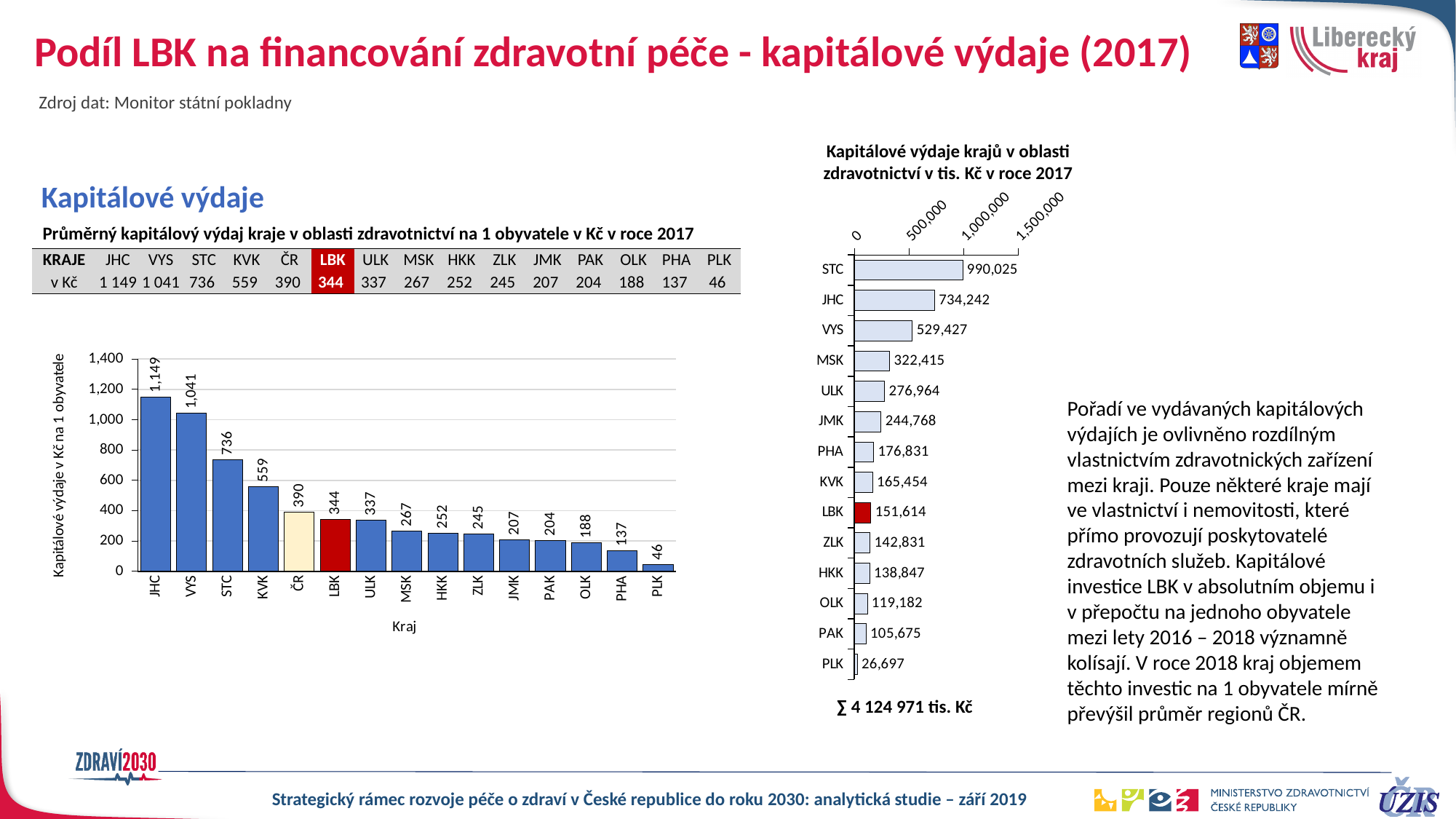
In the left chart (Kapitálové výdaje v Kč na 1 obyvatele), what is the value for LBK? 344 In the left chart (Kapitálové výdaje v Kč na 1 obyvatele), which kraj has the lowest value? PLK In the left chart (Kapitálové výdaje v Kč na 1 obyvatele), what is the difference between the values for ČR and LBK? 46 In the right chart (Kapitálové výdaje krajů v oblasti zdravotnictví v tis. Kč v roce 2017), what colour is the bar for LBK? red In the left chart (Kapitálové výdaje v Kč na 1 obyvatele), which kraj has the highest value? JHC In the right chart (Kapitálové výdaje krajů v oblasti zdravotnictví v tis. Kč v roce 2017), which is larger, the value for MSK or the value for ULK? MSK In the left chart (Kapitálové výdaje v Kč na 1 obyvatele), do the values rise or fall from left to right along the x axis? fall In the left chart (Kapitálové výdaje v Kč na 1 obyvatele), how many bars are plotted? 15 In the right chart (Kapitálové výdaje krajů v oblasti zdravotnictví v tis. Kč v roce 2017), which kraj has the highest value? STC In the right chart (Kapitálové výdaje krajů v oblasti zdravotnictví v tis. Kč v roce 2017), what is the value for LBK? 151,614 What kind of chart is the left chart (Kapitálové výdaje v Kč na 1 obyvatele)? bar chart In the right chart (Kapitálové výdaje krajů v oblasti zdravotnictví v tis. Kč v roce 2017), how many krajs are plotted? 14